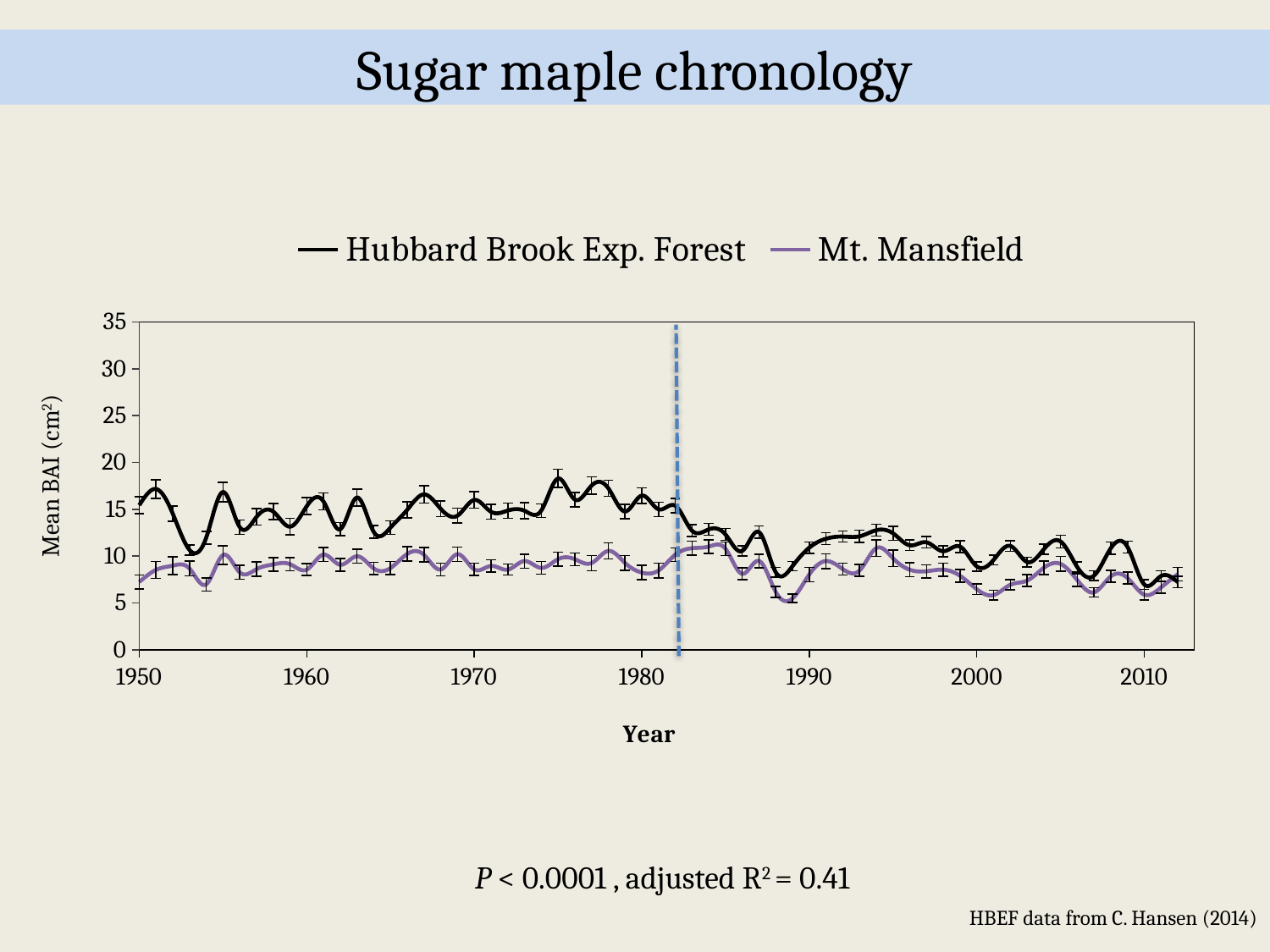
Is the value for Hubbard Brook Exp. Forest in 1951 greater or less than 15? greater Overall, does the Hubbard Brook Exp. Forest series rise or fall from 1980 to 2010? fall How many years are labeled on the x axis? 7 What kind of chart is shown on the slide? line chart Is the value for Hubbard Brook Exp. Forest in 1989 greater or less than 10? less What is the title of the chart? Sugar maple chronology Is the value for Hubbard Brook Exp. Forest in 1975 greater or less than 15? greater What is the label on the y axis? Mean BAI (cm²) In 1970, which series has the higher value, Hubbard Brook Exp. Forest or Mt. Mansfield? Hubbard Brook Exp. Forest How many series does the legend list? 2